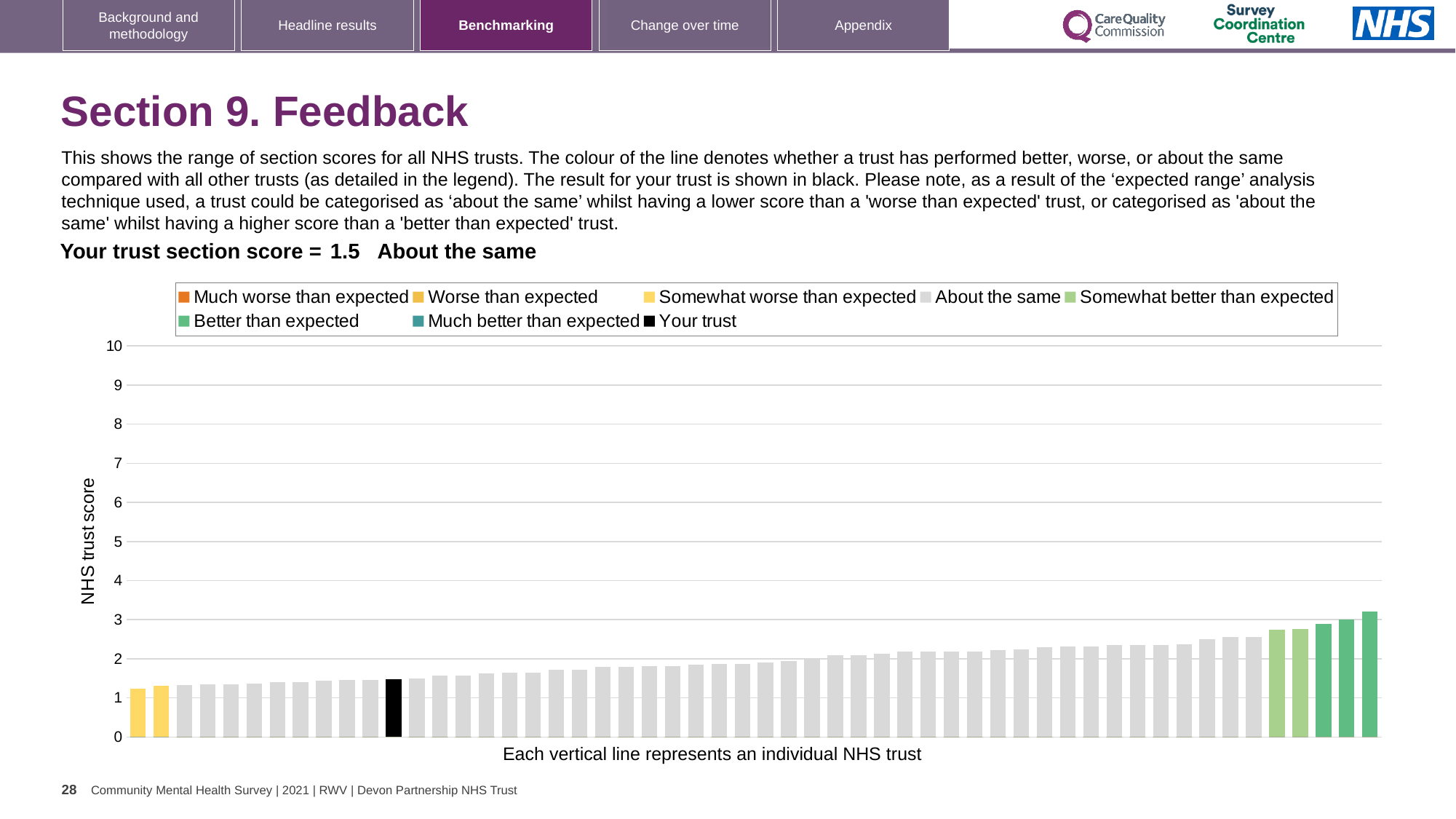
Which benchmarking category is your trust placed in for this section? About the same How many entries does the chart legend list? 8 Is the value of the tallest bar greater or less than 2? greater How many bars are coloured yellow (Somewhat worse than expected)? 2 Is the value for your trust greater or less than 5? less Do the bar values rise or fall from left to right along the x axis? rise Which legend category does the lowest-scoring trust belong to? Somewhat worse than expected Is the value of the leftmost (lowest) bar greater or less than 2? less Which legend category does the highest-scoring trust belong to? Better than expected What is the section score for your trust? 1.5 What is the label on the vertical axis of the chart? NHS trust score What kind of chart is shown on the slide? bar chart